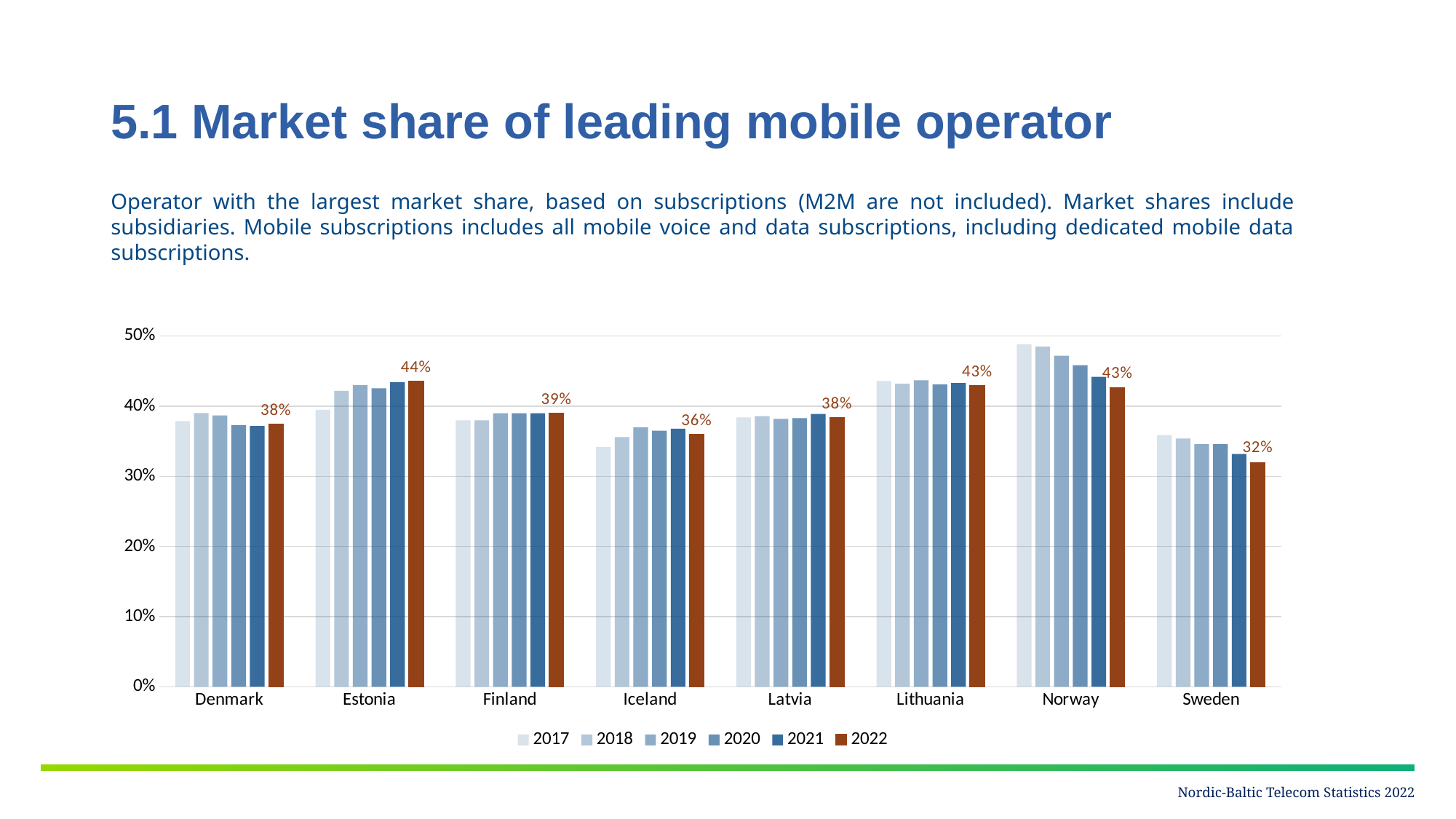
What is the 2022 value shown for Sweden? 32% Which country has the highest 2022 market share for its leading mobile operator? Estonia What is the 2022 value shown for Iceland? 36% Which country has the lowest 2022 market share for its leading mobile operator? Sweden Is the 2017 value for Norway greater or less than 40%? greater Which is larger in 2022, the value for Finland or the value for Iceland? Finland What is the market share of the leading mobile operator in Estonia in 2022? 44% How many series (years) does the legend list? 6 Do the values for Sweden rise or fall from 2017 to 2022? fall How many countries are shown on the x axis of the chart? 8 What is the difference between the 2022 values for Estonia and Sweden? 12 percentage points Is the 2017 value for Iceland greater or less than 40%? less